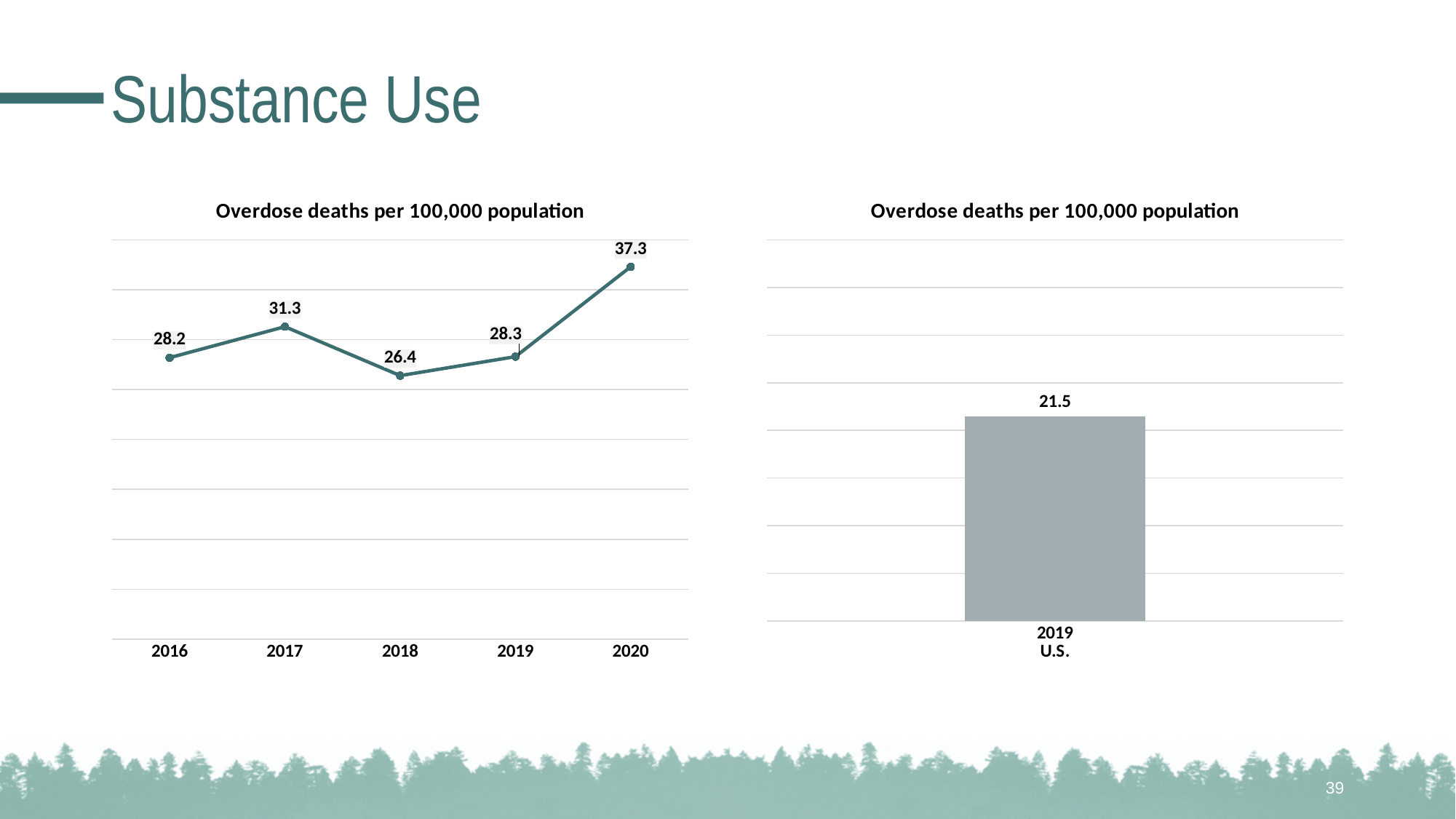
In the left chart, what is the value for 2016? 28.2 What is the title of the right chart? Overdose deaths per 100,000 population What kind of chart is the left chart? line chart In the left chart, which is larger, the value for 2017 or the value for 2019? 2017 In the right chart, what is the value for 2019 U.S.? 21.5 In the left chart, what is the difference between the values for 2020 and 2019? 9.0 How many data points are plotted in the left chart? 5 In the left chart, what is the value for 2020? 37.3 In the left chart, which year has the lowest value? 2018 What kind of chart is the right chart? bar chart In the left chart, which year has the highest value? 2020 In the left chart, what is the value for 2018? 26.4